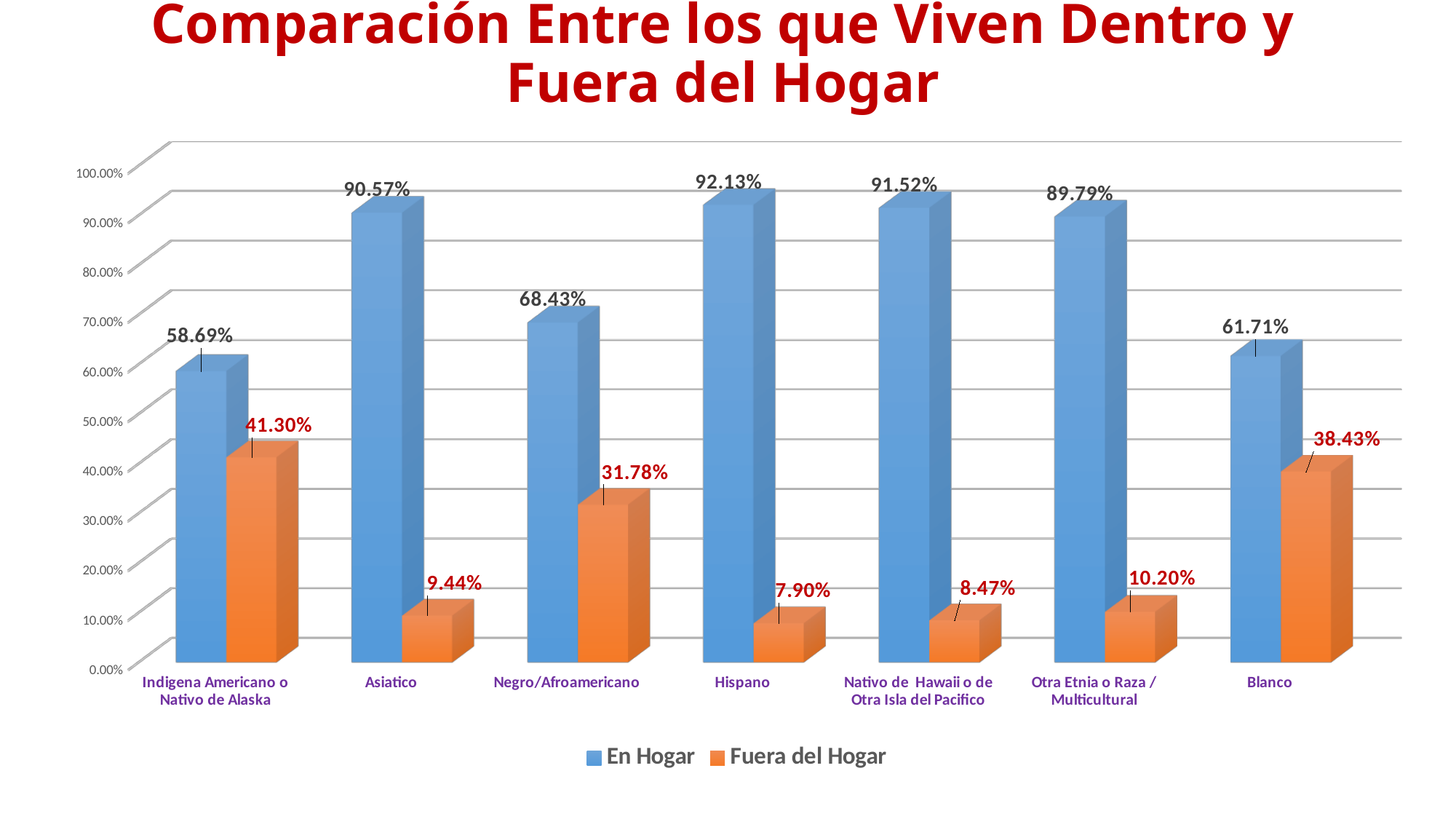
Which category has the highest En Hogar value? Hispano How many series does the legend list? 2 What is the difference between the En Hogar and Fuera del Hogar values for Negro/Afroamericano? 36.65% What kind of chart is shown on the slide? Bar chart What is the En Hogar value for Hispano? 92.13% Which is larger: the Fuera del Hogar value for Asiatico or for Otra Etnia o Raza / Multicultural? Otra Etnia o Raza / Multicultural Which category has the lowest Fuera del Hogar value? Hispano What is the Fuera del Hogar value for Indigena Americano o Nativo de Alaska? 41.30% What colour are the Fuera del Hogar bars? Orange What is the Fuera del Hogar value for Blanco? 38.43% How many categories are shown on the x axis? 7 Which category has the lowest En Hogar value? Indigena Americano o Nativo de Alaska